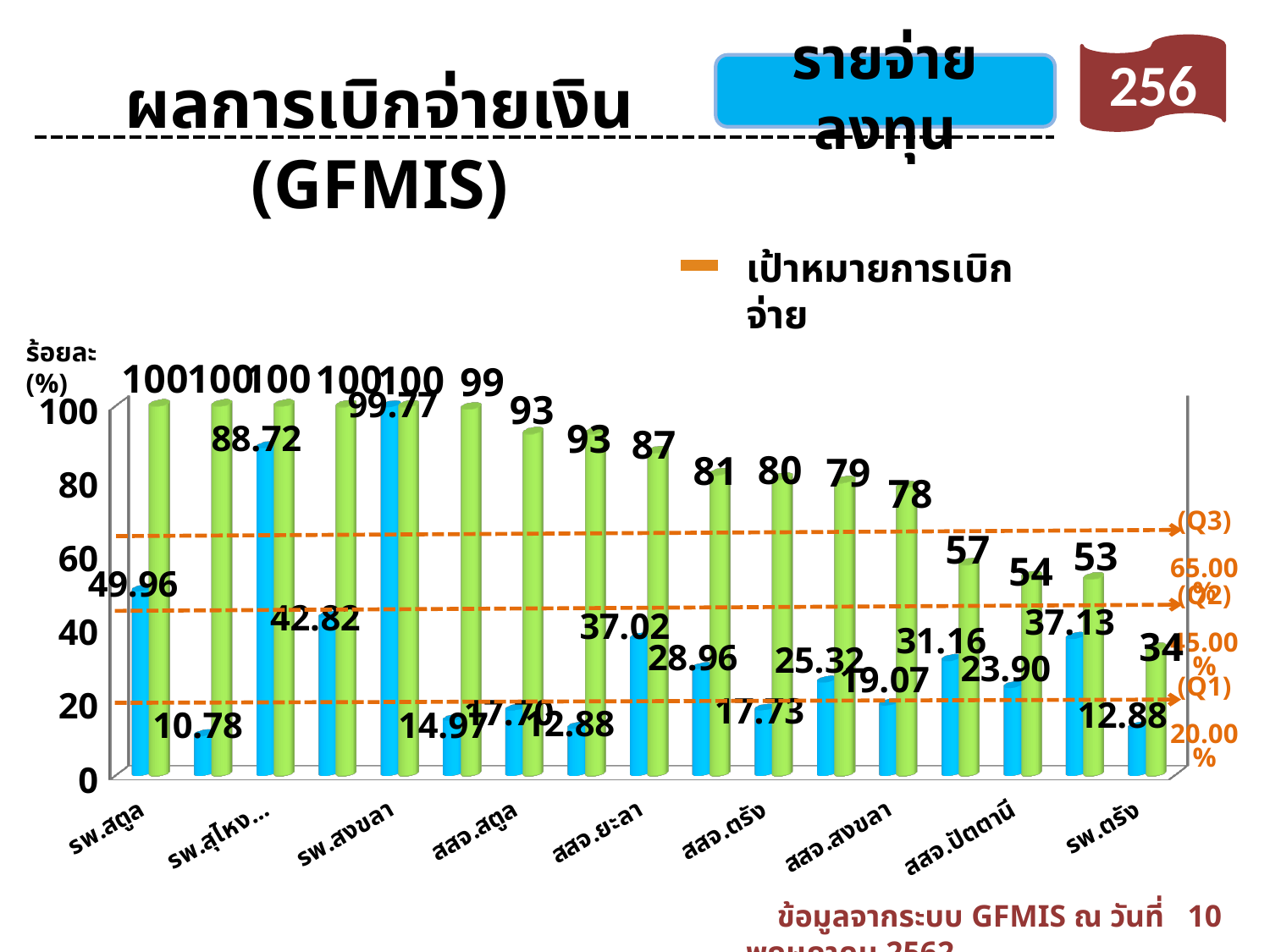
What kind of chart is shown on the slide? bar chart What is the value of the green bar for รพ.ตรัง? 34 What target value is shown for the Q3 dashed line? 65.00 % What is the value of the blue bar for รพ.สงขลา? 99.77 What target value is shown for the Q1 dashed line? 20.00 % What is the value of the blue bar for สสจ.ยะลา? 37.02 Do the green bars rise or fall from left to right along the x axis? fall Which category has the highest blue bar? รพ.สงขลา Is the green bar for สสจ.ปัตตานี greater or less than 60? less Which category has the lowest green bar? รพ.ตรัง Which has the larger blue bar, รพ.สตูล or รพ.สุไหง...? รพ.สุไหง... What is the difference between the green bar and the blue bar for รพ.สตูล? 50.04